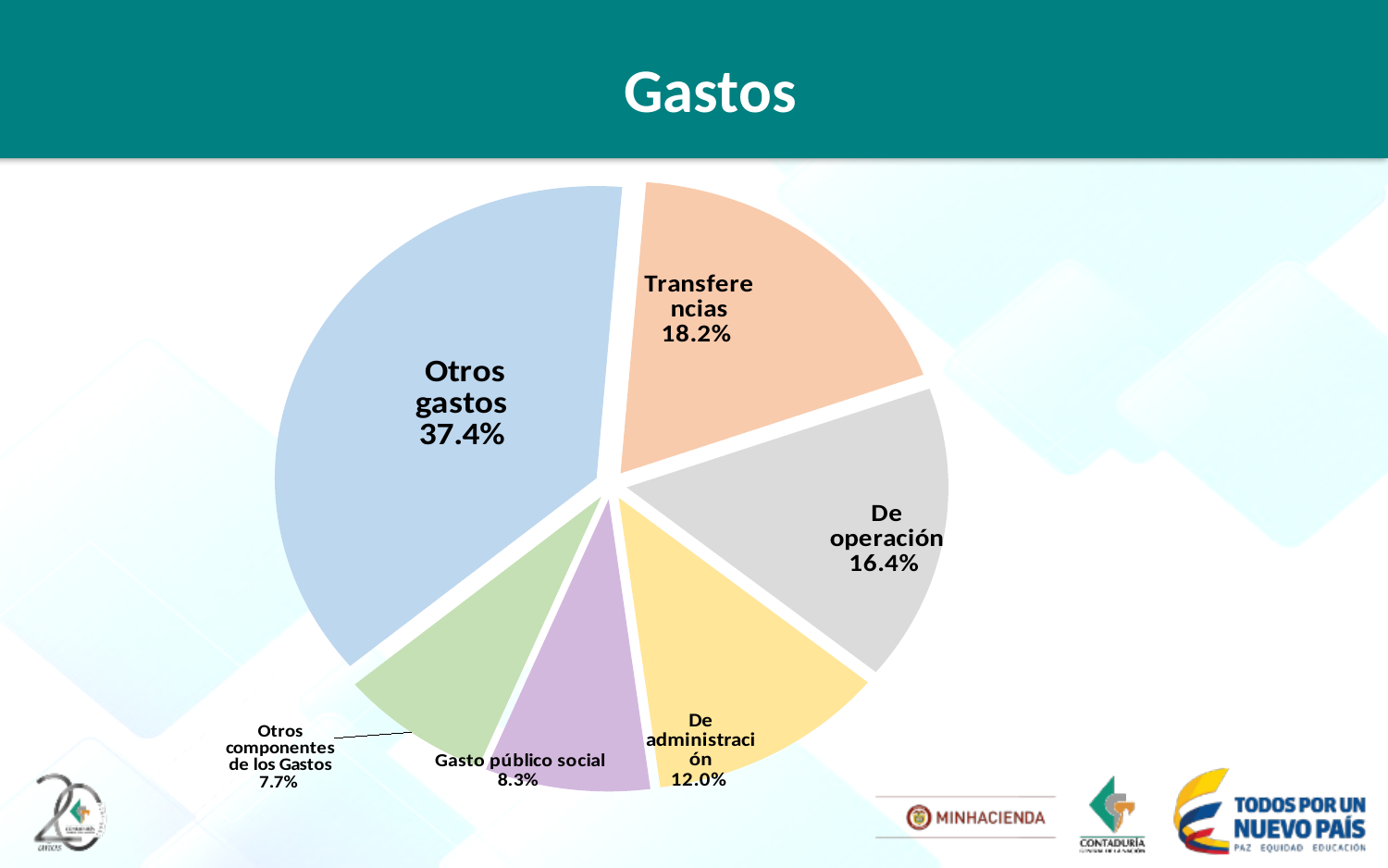
How many slices does the pie chart have? 6 What percentage is shown for De operación? 16.4% What share of the pie does Otros gastos represent? 37.4% What share is labelled for Gasto público social? 8.3% What is the value shown for Transferencias? 18.2% Which category has the largest slice of the pie? Otros gastos Which is larger, De operación or De administración? De operación What is the value for Otros componentes de los Gastos? 7.7% What is the difference in percentage points between Otros gastos and Transferencias? 19.2 What is the value for De administración? 12.0% What type of chart is shown on the slide? Pie chart Which category has the smallest slice of the pie? Otros componentes de los Gastos